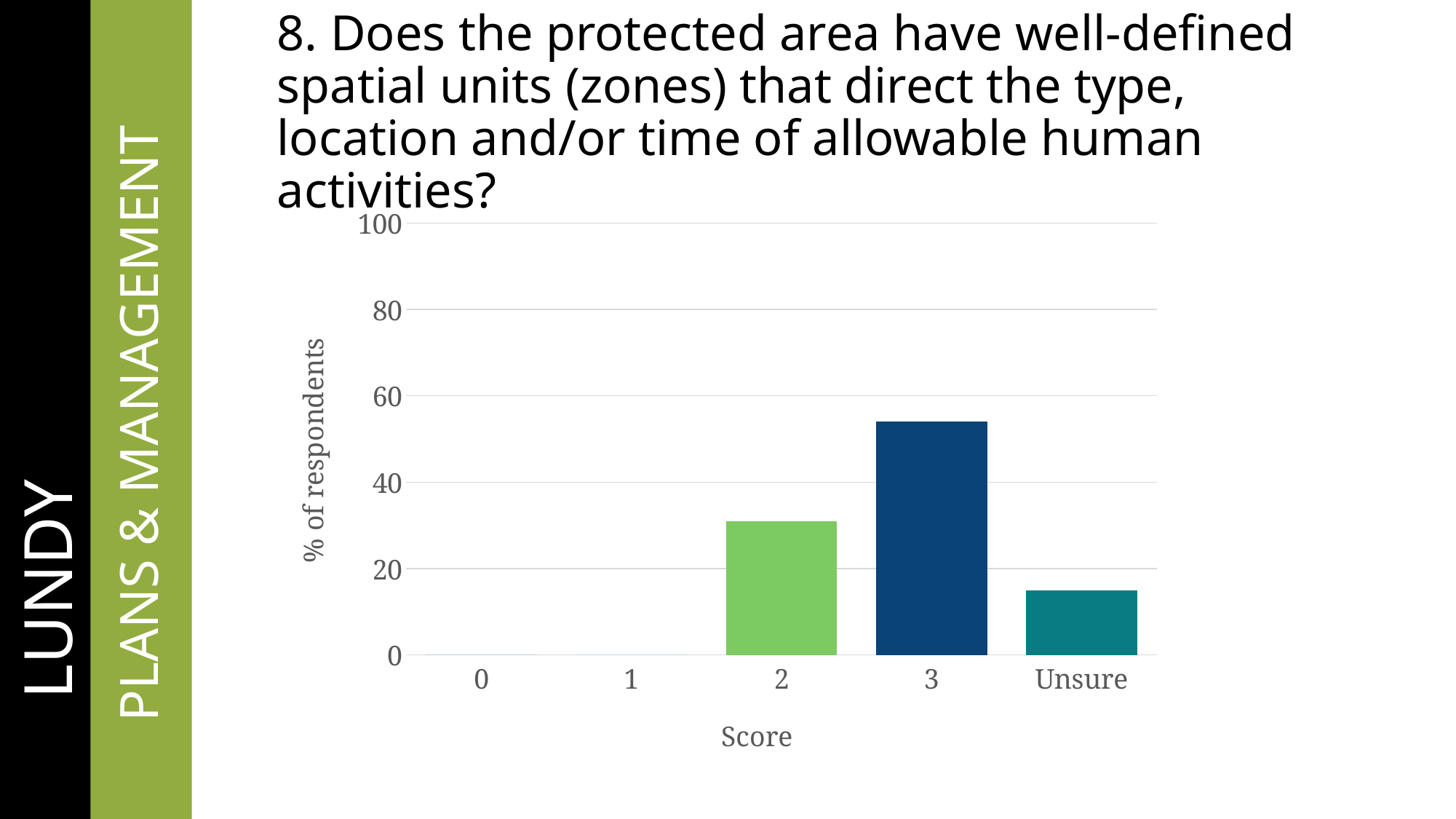
How many categories are shown on the x axis of the chart? 5 What kind of chart is shown on the slide? bar chart Is the value for score 3 greater or less than 40? greater Is the value for score 0 greater or less than 20? less Which score category has the highest percentage of respondents? 3 Which has a higher percentage of respondents, score 2 or Unsure? 2 Is the value for score 2 greater or less than 40? less What is the label of the x axis? Score What is the label of the y axis? % of respondents